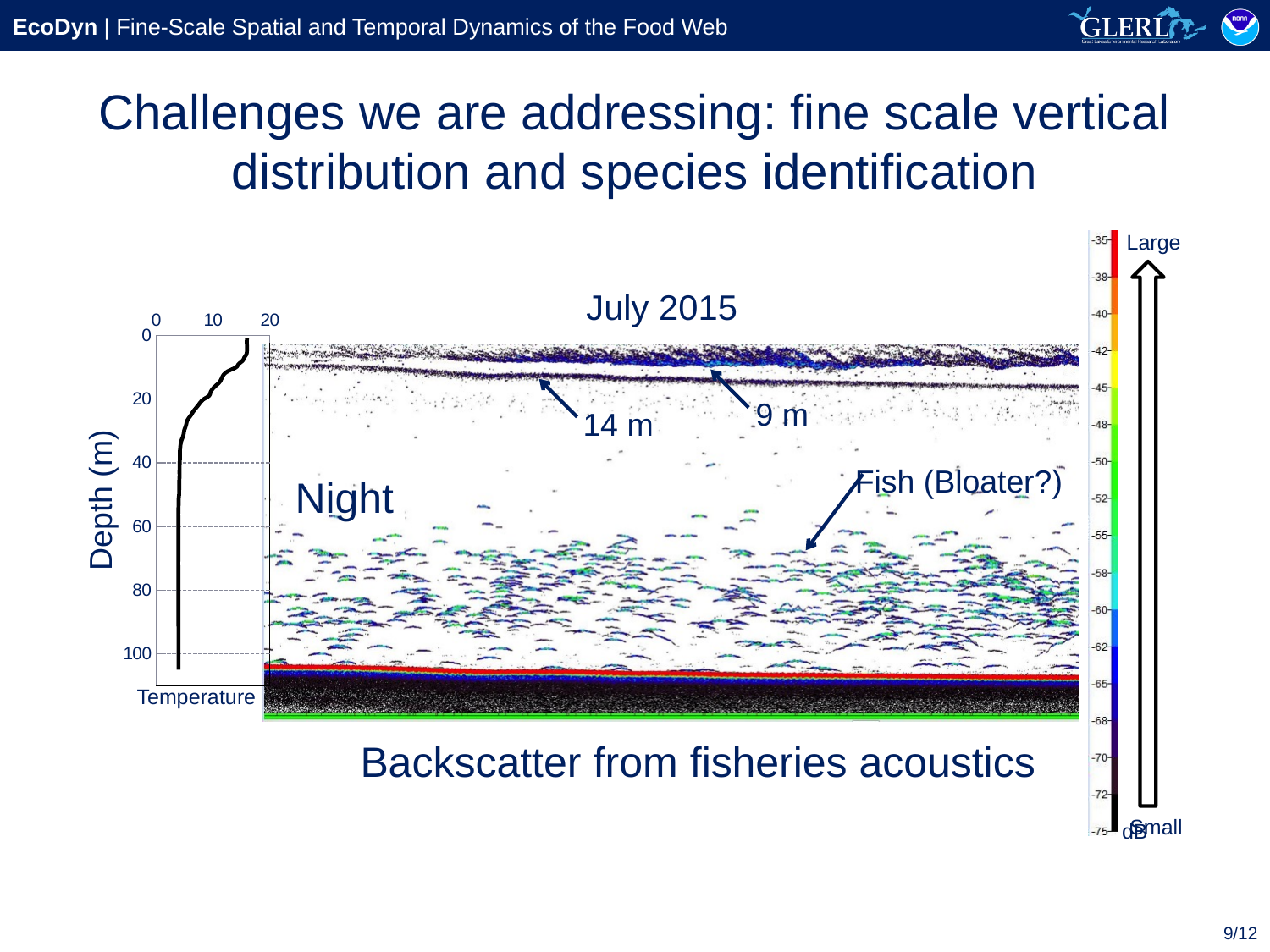
What is the label on the vertical axis of the temperature profile chart? Depth (m) In the temperature profile chart, is the temperature at a depth of 80 m greater or less than 10? less What is the highest tick value labelled on the horizontal axis of the temperature profile chart? 20 What is the bottom value labelled on the dB colour scale to the right of the echogram? -75 What kind of chart is the temperature profile on the left of the slide? line chart In the temperature profile chart, which depth has the higher temperature, 0 m or 60 m? 0 m In the temperature profile chart, is the temperature at a depth of 0 m greater or less than 10? greater In the temperature profile chart, does temperature rise or fall as depth increases from 0 m to 40 m? fall